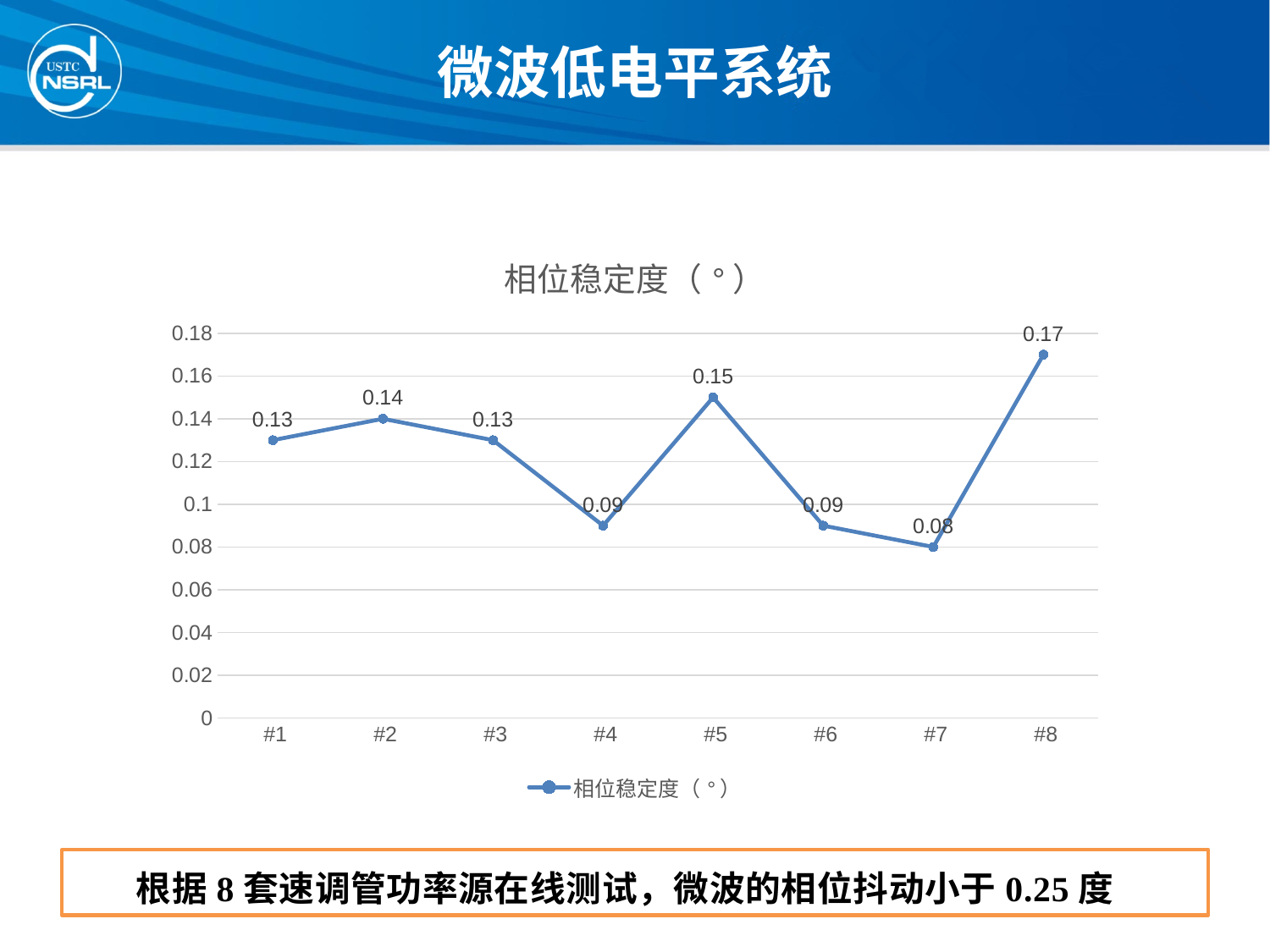
What is the value for #1? 0.13 What is the title of the chart? 相位稳定度（°） Which category has the lowest value? #7 Which is larger, the value for #2 or the value for #4? #2 What is the difference between the values for #8 and #7? 0.09 How many categories are plotted on the x axis? 8 Which category has the highest value? #8 What is the value for #5? 0.15 What is the value for #7? 0.08 What kind of chart is shown? line chart How many series does the legend list? 1 Is the value for #8 greater or less than 0.16? greater